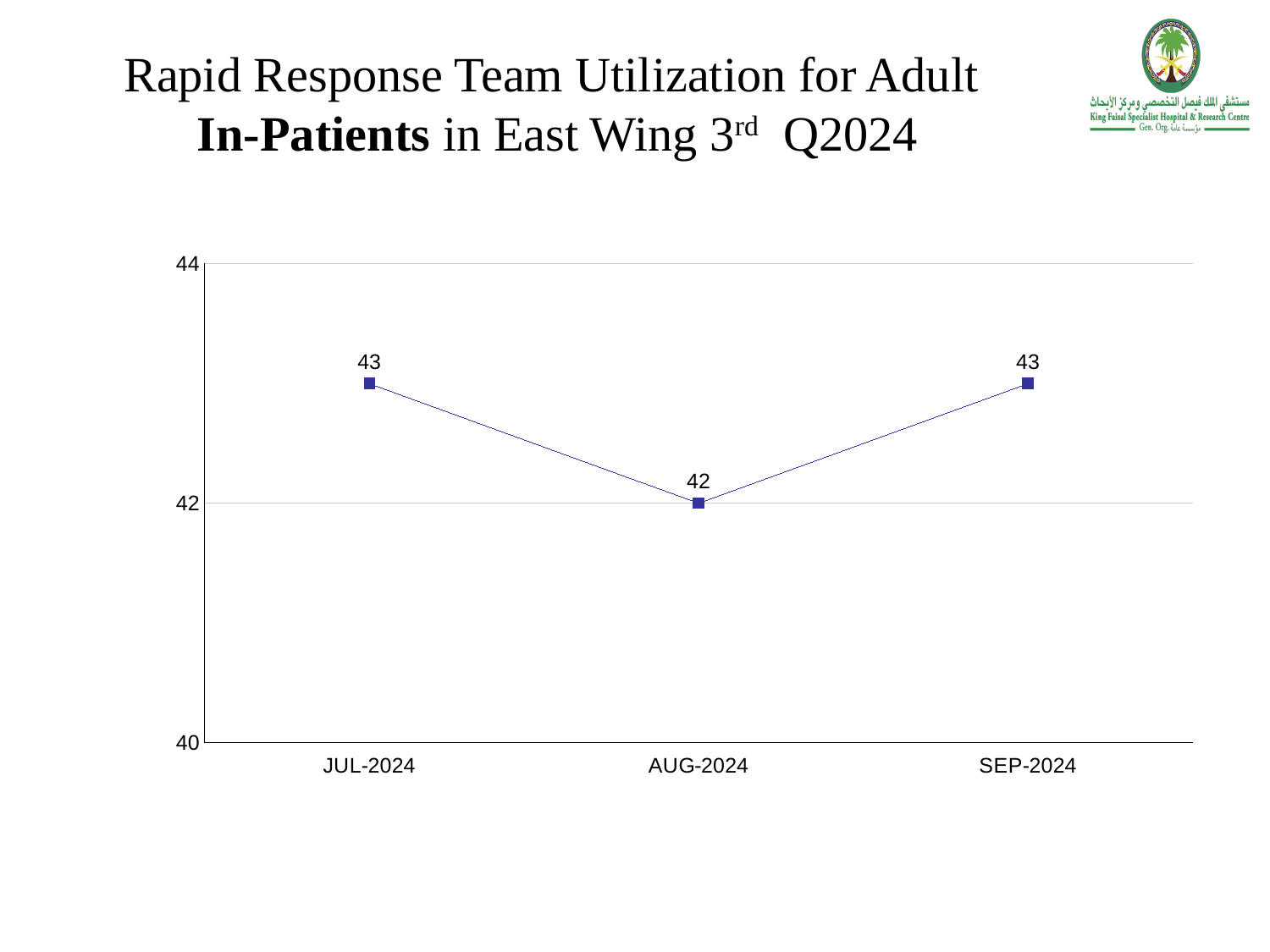
Which is larger, the value for AUG-2024 or the value for SEP-2024? SEP-2024 What is the value for JUL-2024? 43 How many months are plotted on the chart? 3 What is the value for AUG-2024? 42 What kind of chart is shown on the slide? line chart Does the value rise or fall from JUL-2024 to AUG-2024? fall Which month has the lowest value? AUG-2024 What is the total of the three plotted values? 128 What is the value for SEP-2024? 43 Is the value for AUG-2024 greater or less than 44? less Does the value rise or fall from AUG-2024 to SEP-2024? rise What is the difference between the values for JUL-2024 and AUG-2024? 1